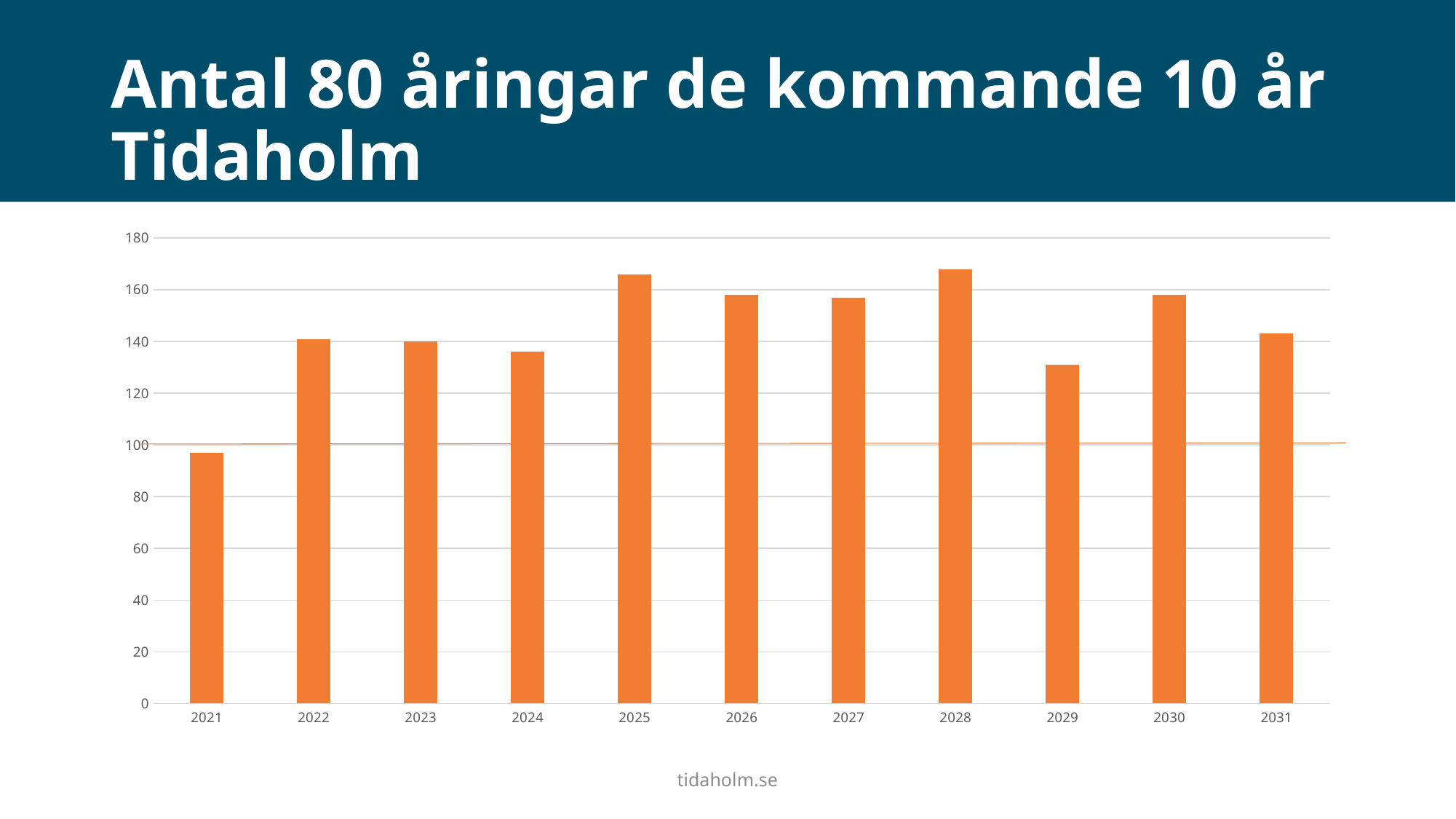
Does the value rise or fall from 2028 to 2029? fall Is the value for 2029 greater or less than 140? less Is the value for 2028 greater or less than 160? greater Is the value for 2021 greater or less than 100? less What kind of chart is shown on the slide? bar chart What is the title of the slide containing the chart? Antal 80 åringar de kommande 10 år Tidaholm Which year has the larger value, 2021 or 2022? 2022 How many years are shown on the x axis of the chart? 11 Which year has the lowest number of 80-year-olds in the chart? 2021 Which year has the larger value, 2029 or 2025? 2025